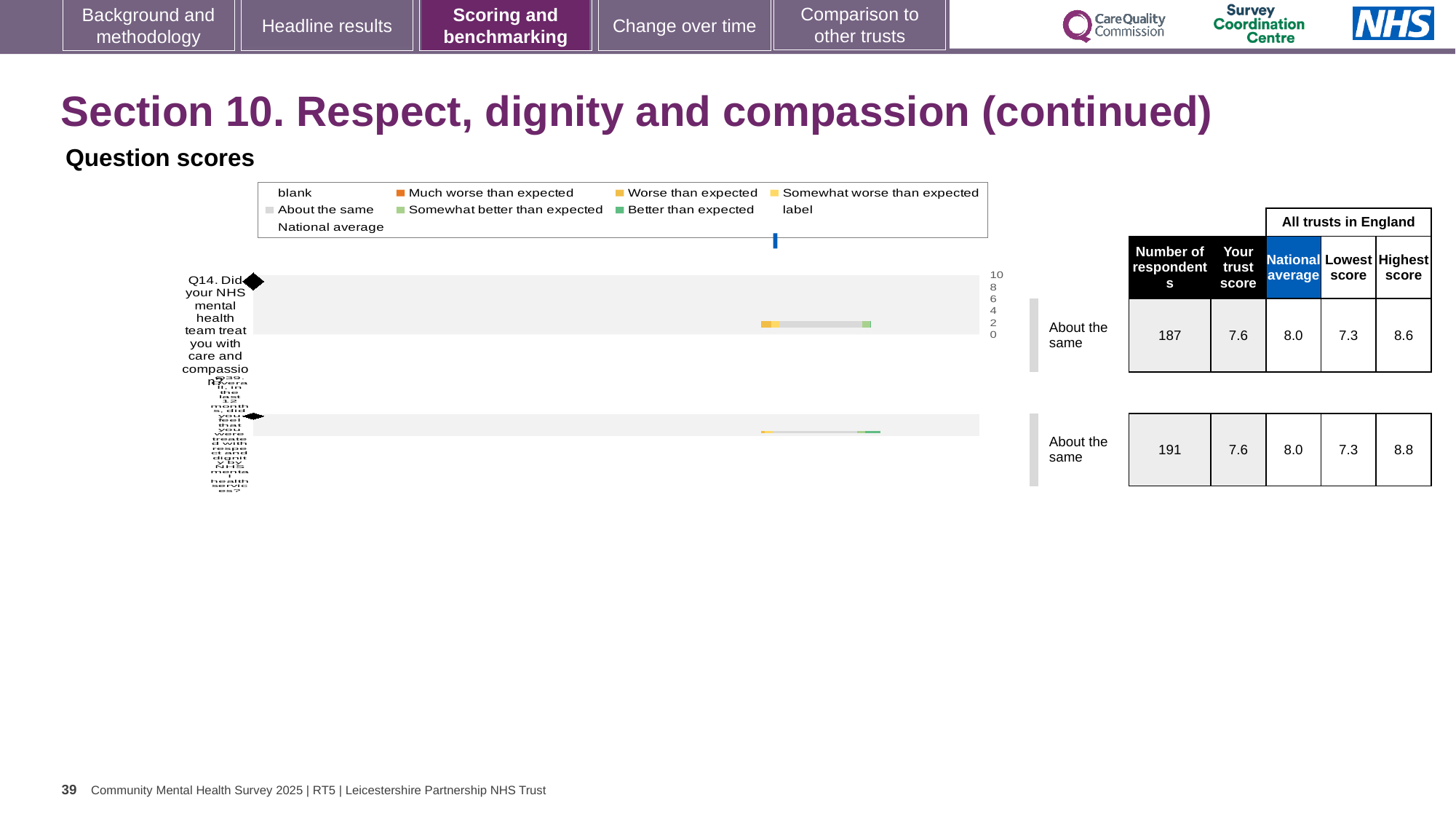
What benchmark category is shown for Q14 (care and compassion) in the chart? About the same What type of chart is used to show the question scores on this slide? bar chart How many respondents are listed for Q14 in the table beside the chart? 187 What is the national average for Q14 in the table beside the chart? 8.0 Which question has the higher highest score across all trusts in England, Q14 or Q39? Q39 What is the trust score for Q14 in the table beside the chart? 7.6 How many questions are plotted in the question scores chart? 2 What is the highest value shown on the score axis of the chart? 10 How many respondents are listed for the second question (Q39) in the table beside the chart? 191 For Q14, what is the difference between the highest score and the lowest score across all trusts in England? 1.3 For Q14, which is larger: the trust score or the national average? National average What is the highest score across all trusts in England for the second question (Q39)? 8.8